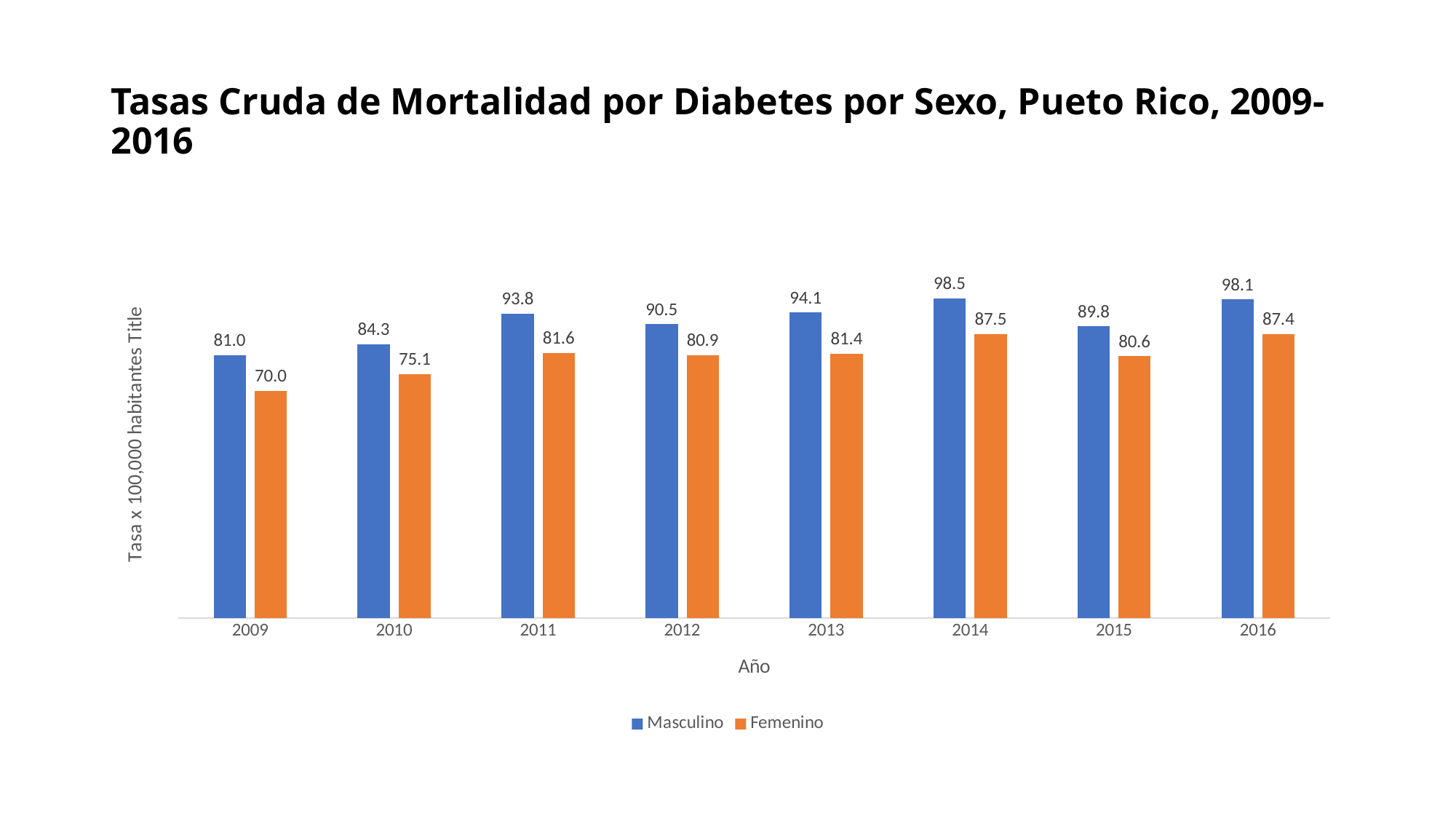
How many years are shown on the x axis? 8 What is the Femenino value for 2009? 70.0 Which year has the lowest Femenino value? 2009 What is the Femenino value for 2012? 80.9 What is the difference between the Masculino and Femenino values in 2009? 11.0 What kind of chart is shown on the slide? Bar chart Which is larger, the Masculino value for 2011 or the Masculino value for 2012? Masculino value for 2011 What is the difference between the Femenino values for 2016 and 2015? 6.8 Which year has the highest Masculino value? 2014 How many series does the legend list? 2 What is the Masculino value for 2014? 98.5 What is the x-axis title of the chart? Año